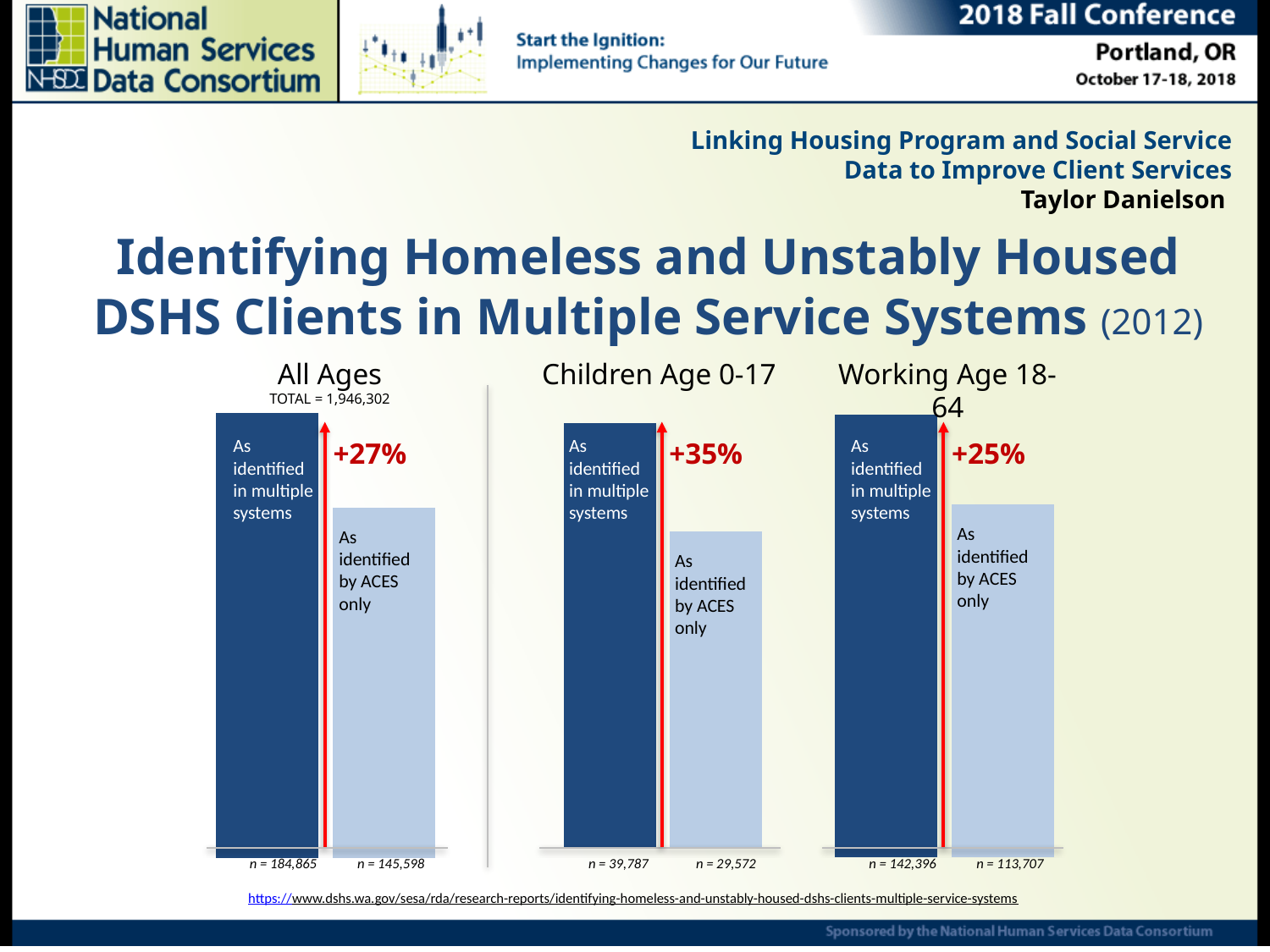
In the Children Age 0-17 chart, what is the n value for clients identified in multiple systems? n = 39,787 How many bars does the Working Age 18-64 chart contain? 2 In the Working Age 18-64 chart, what percentage increase is shown between the ACES-only bar and the multiple-systems bar? +25% In the Children Age 0-17 chart, what percentage increase is shown between the ACES-only bar and the multiple-systems bar? +35% What type of chart is used for the All Ages data? Bar chart In the Children Age 0-17 chart, which bar is taller: identified in multiple systems or identified by ACES only? As identified in multiple systems In the Working Age 18-64 chart, what is the n value for clients identified in multiple systems? n = 142,396 In the All Ages chart, what is the difference in n between clients identified in multiple systems and clients identified by ACES only? 39,267 In the Working Age 18-64 chart, what is the n value for clients identified by ACES only? n = 113,707 In the All Ages chart, what is the n value for clients identified in multiple systems? n = 184,865 In the Children Age 0-17 chart, what is the n value for clients identified by ACES only? n = 29,572 In the All Ages chart, what is the n value for clients identified by ACES only? n = 145,598